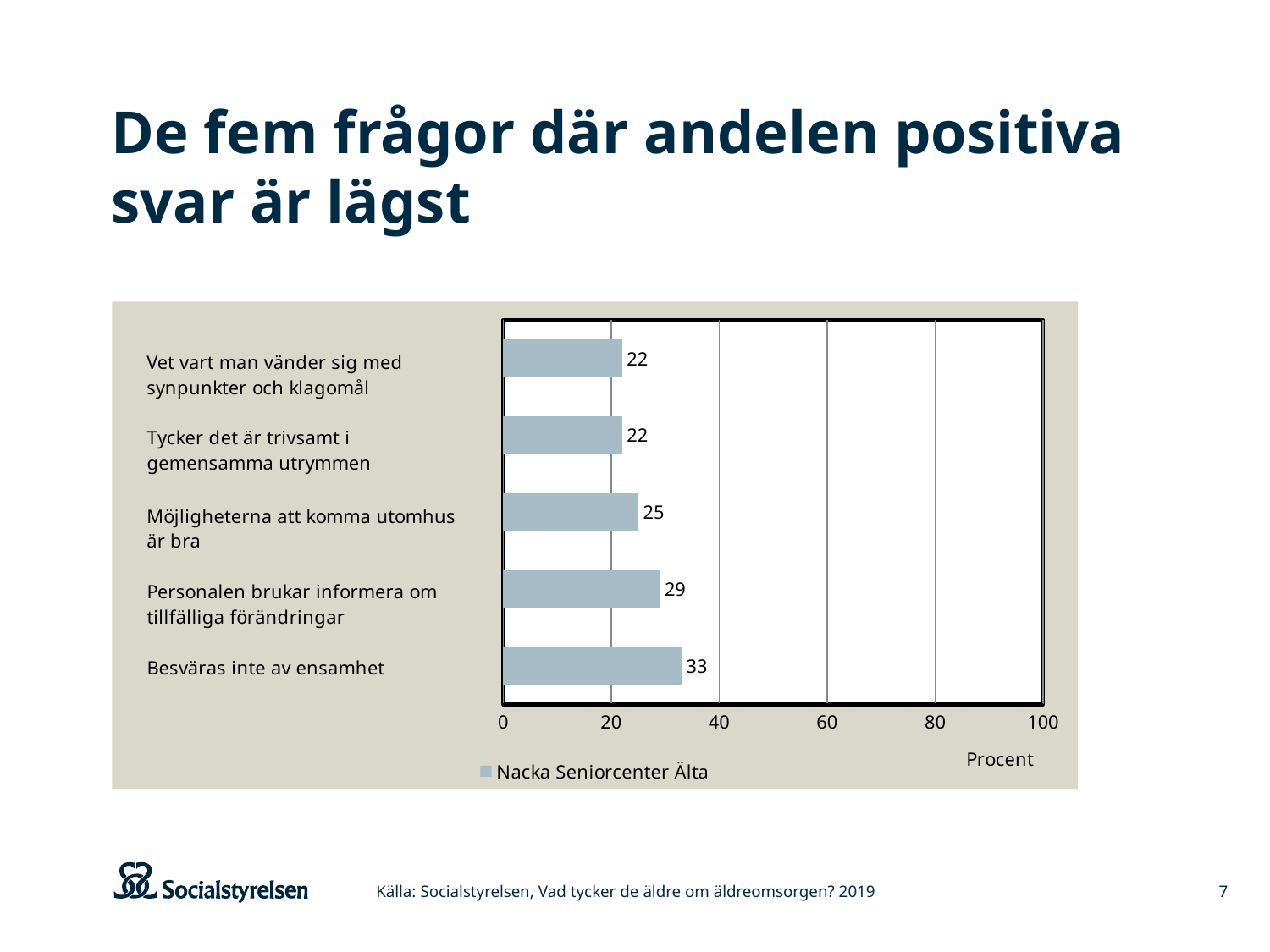
Which category has the highest value? Besväras inte av ensamhet What is the value for "Personalen brukar informera om tillfälliga förändringar"? 29 Which is larger: the value for "Personalen brukar informera om tillfälliga förändringar" or for "Möjligheterna att komma utomhus är bra"? Personalen brukar informera om tillfälliga förändringar What kind of chart is shown on the slide? bar chart What series name is shown in the legend? Nacka Seniorcenter Älta What is the value for "Möjligheterna att komma utomhus är bra"? 25 What is the value for "Besväras inte av ensamhet"? 33 What is the value for "Tycker det är trivsamt i gemensamma utrymmen"? 22 What is the difference between the values for "Besväras inte av ensamhet" and "Vet vart man vänder sig med synpunkter och klagomål"? 11 How many categories are shown in the chart? 5 How many series does the legend list? 1 Is the value for "Besväras inte av ensamhet" greater or less than 40? less